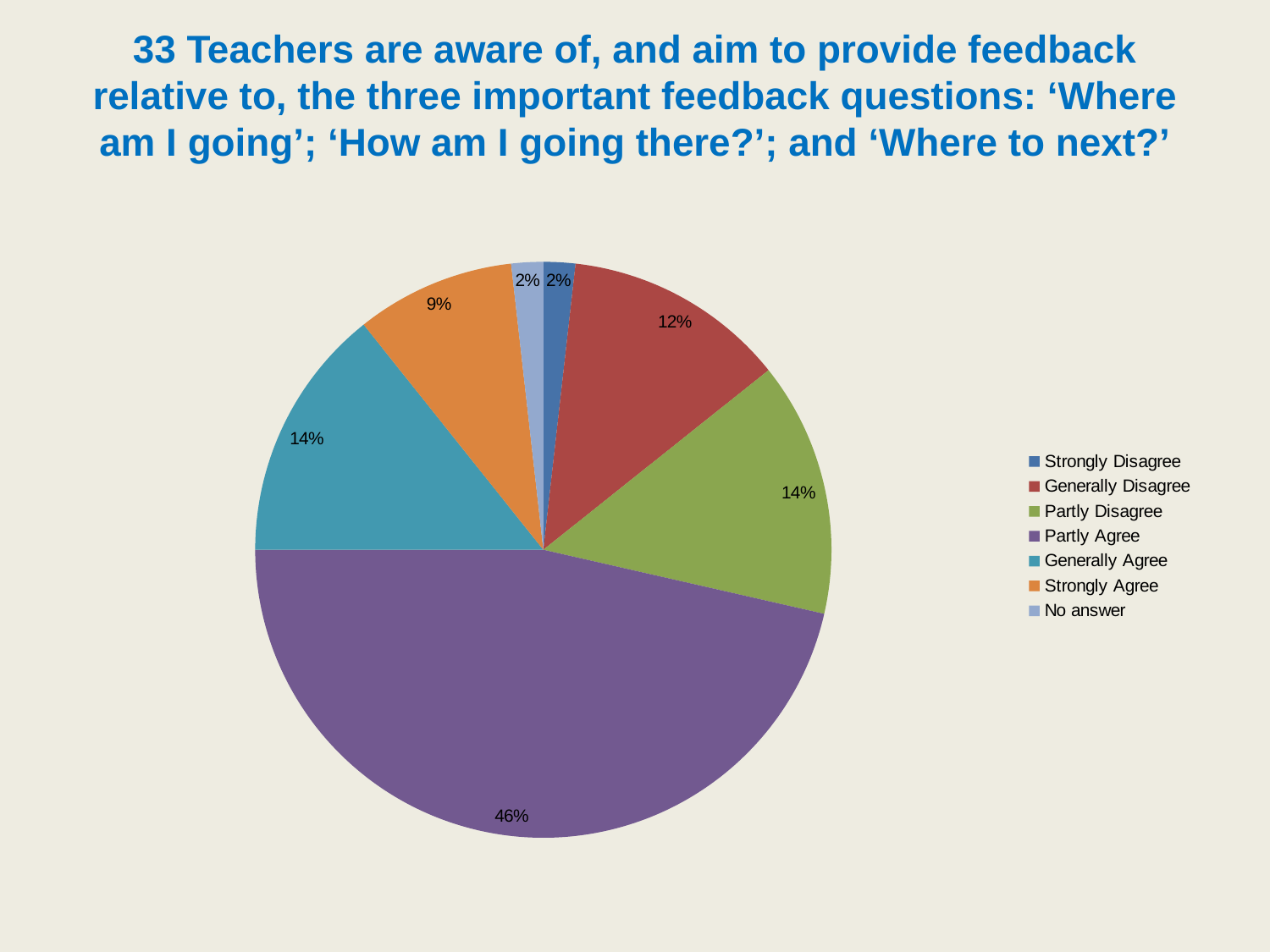
What share does Generally Disagree have in the pie chart? 12% What is the difference in percentage points between Partly Agree and Generally Agree? 32 Which response category has the largest slice of the pie? Partly Agree Which legend entry is listed last? No answer What percentage is shown for Strongly Agree? 9% Which is larger, the Generally Disagree slice or the Strongly Agree slice? Generally Disagree How many categories does the legend list? 7 What percentage of the pie chart is Partly Agree? 46% What percentage of responses were No answer? 2% What type of chart is shown on the slide? Pie chart What percentage is shown for Partly Disagree? 14% What colour is the Partly Agree slice? Purple